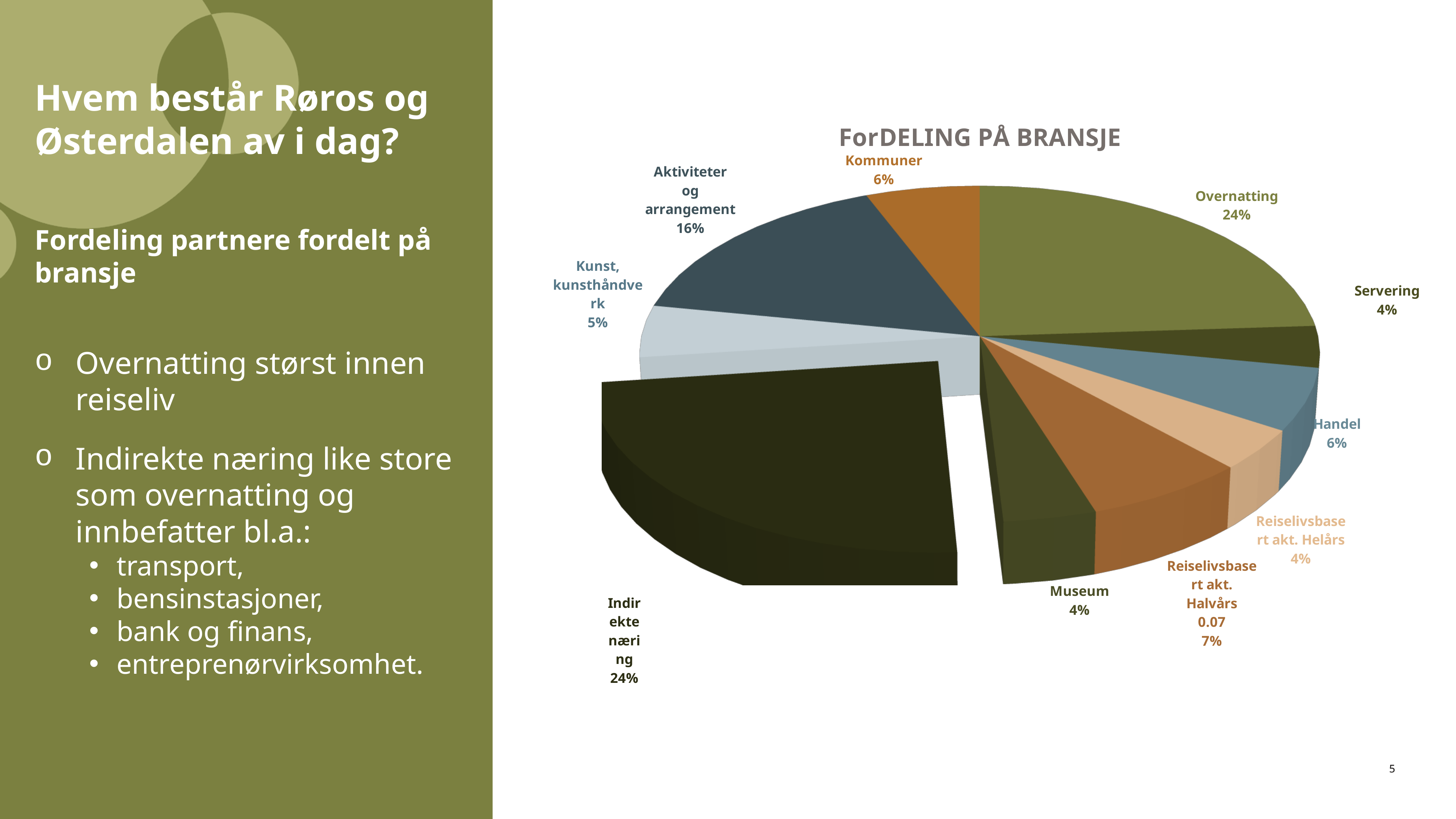
What percentage is shown for Kommuner? 6% Which is larger, Aktiviteter og arrangement or Handel? Aktiviteter og arrangement What is the difference in percentage points between Reiselivsbasert akt. Halvårs and Reiselivsbasert akt. Helårs? 3 What is the title of the chart? ForDELING PÅ BRANSJE What percentage is shown for Aktiviteter og arrangement? 16% What is the difference in percentage points between Overnatting and Aktiviteter og arrangement? 8 How many slices does the pie chart have? 10 What share of the pie does Overnatting have? 24% What kind of chart is shown on the slide? Pie chart What percentage is shown for Museum? 4% What percentage is shown for Indirekte næring? 24% What percentage is shown for Kunst, kunsthåndverk? 5%